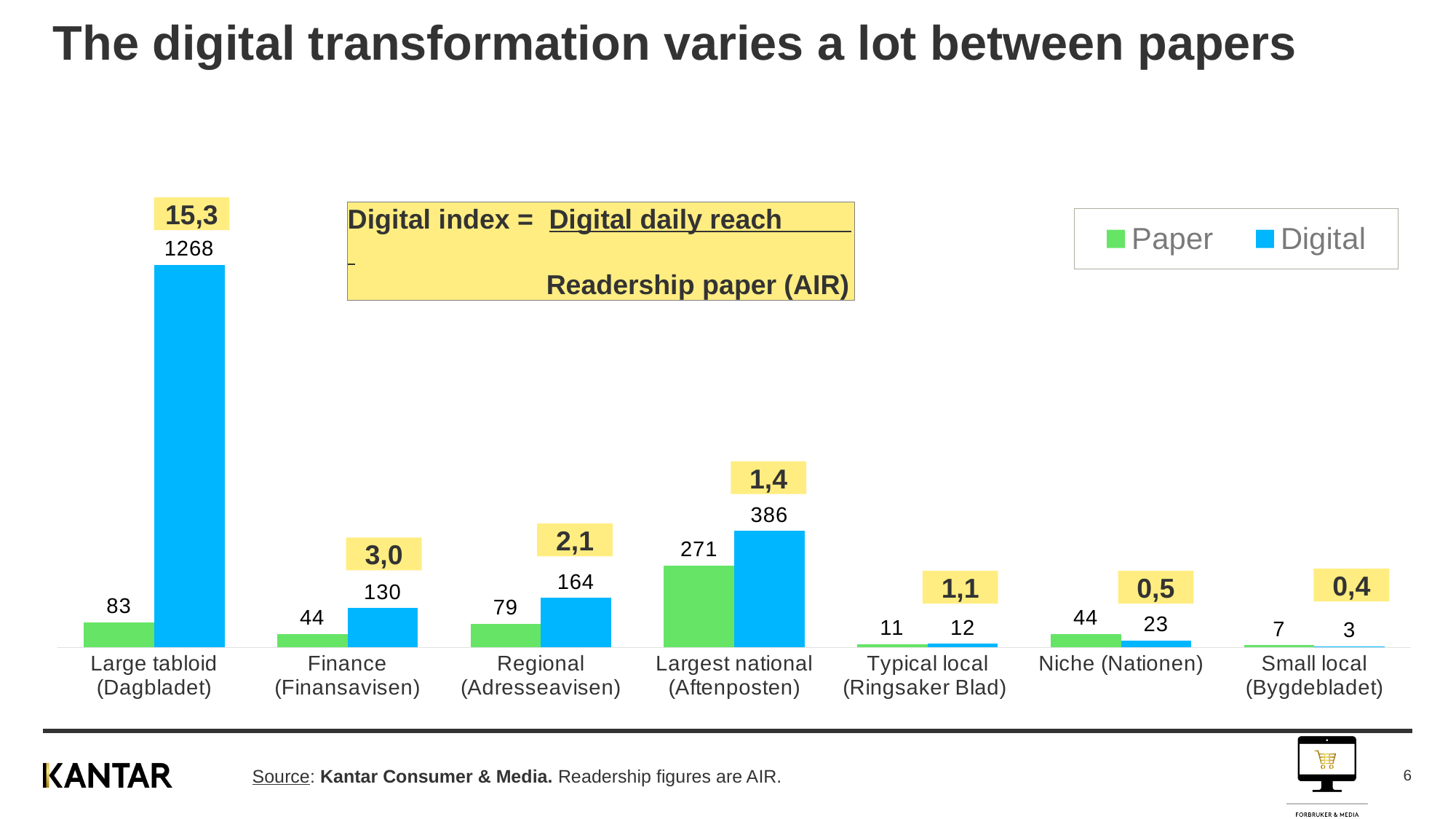
Which category has the lowest Digital value? Small local (Bygdebladet) What is the Digital value for Large tabloid (Dagbladet)? 1268 What is the Paper value for Largest national (Aftenposten)? 271 How many series does the legend list? 2 Which category has the highest Digital value? Large tabloid (Dagbladet) What is the Paper value for Typical local (Ringsaker Blad)? 11 What is the digital index shown for Finance (Finansavisen)? 3,0 What is the difference between the Digital and Paper values for Regional (Adresseavisen)? 85 For Niche (Nationen), which is larger, the Paper value or the Digital value? Paper Which colour represents the Digital series in the legend? Blue What kind of chart is shown on the slide? Bar chart How many categories are shown on the x axis? 7